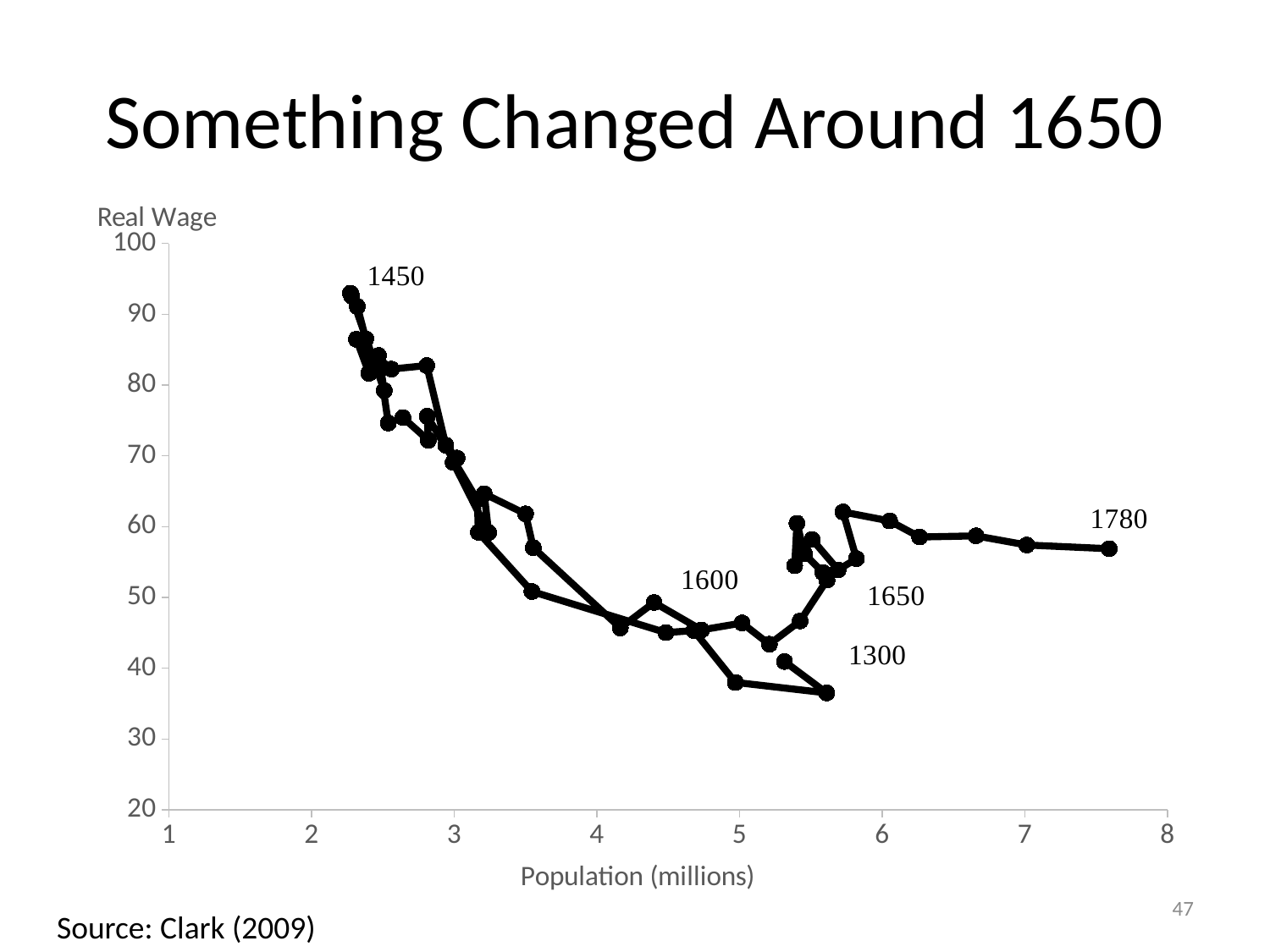
Is the population at the point labelled 1780 greater or less than 7 million? greater Among the labelled years on the chart, which has the lowest real wage? 1300 Is the population at the point labelled 1450 greater or less than 3 million? less What kind of chart is shown on the slide? line chart Is the real wage at the point labelled 1450 greater or less than 90? greater What is the title of the chart on the slide? Something Changed Around 1650 Which of the labelled years, 1300 or 1780, has the larger population? 1780 Which of the labelled years, 1450 or 1780, has the higher real wage? 1450 What is the label of the horizontal axis of the chart? Population (millions)